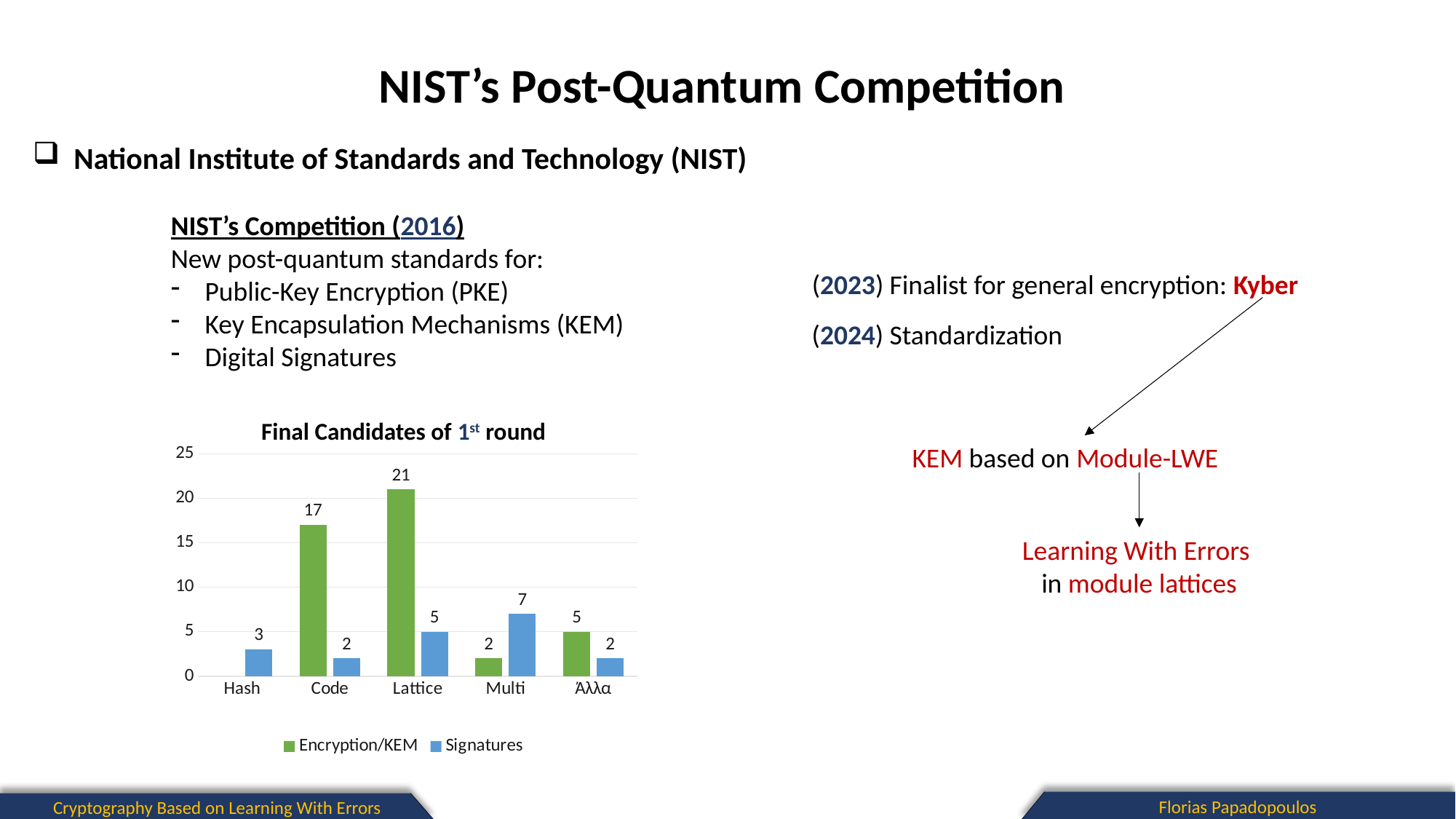
Which is larger for Multi: Encryption/KEM or Signatures? Signatures What type of chart is shown on the slide? Bar chart What is the Encryption/KEM value for Code? 17 What is the Encryption/KEM value for Lattice? 21 What is the Signatures value for Multi? 7 What is the difference between the Encryption/KEM and Signatures values for Lattice? 16 Which category has the highest Encryption/KEM value? Lattice How many categories are shown on the x axis? 5 What is the Signatures value for Hash? 3 What is the difference between the Encryption/KEM values for Lattice and Code? 4 Which category has the highest Signatures value? Multi How many series does the legend list? 2